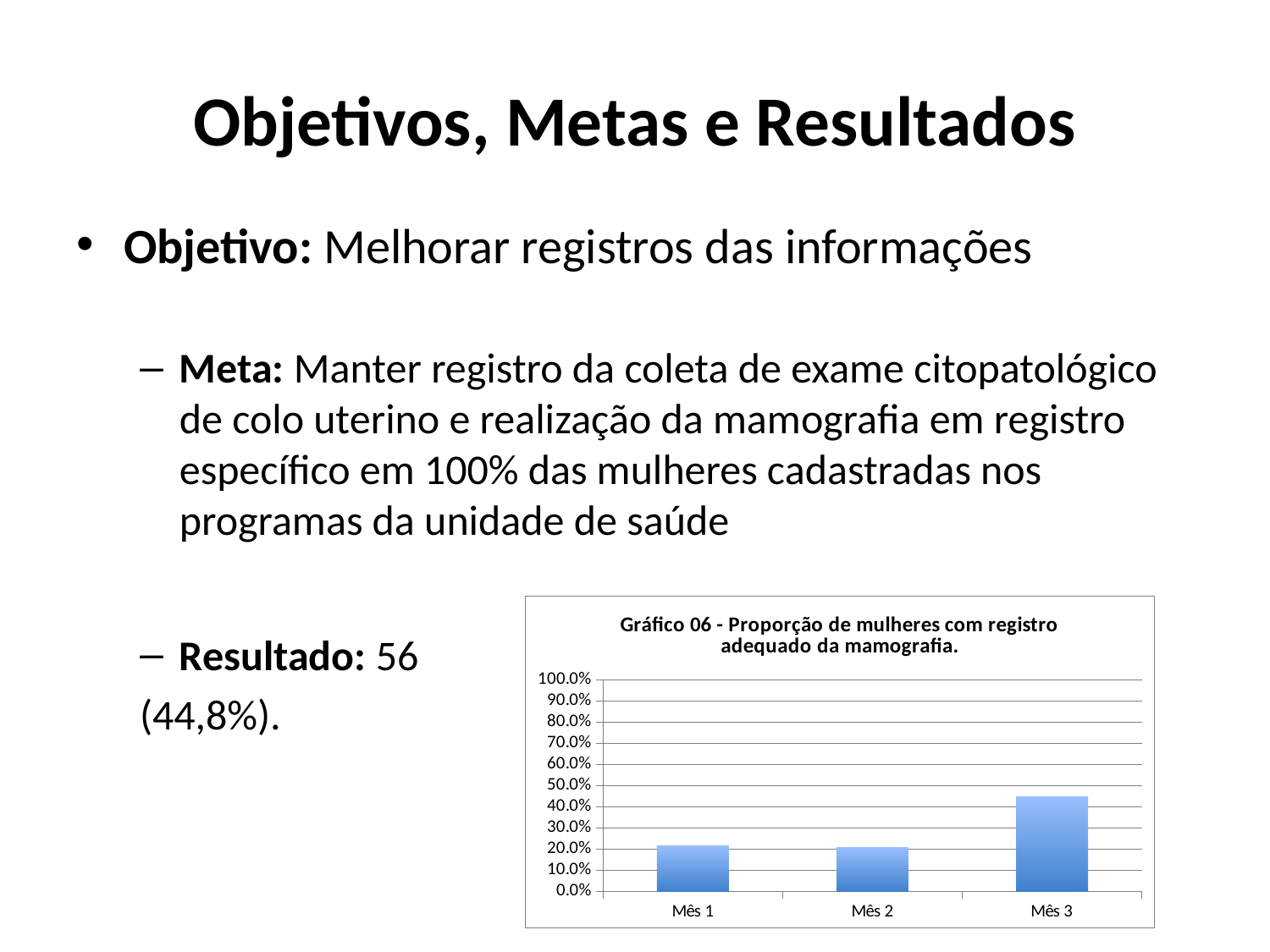
Is the value for Mês 2 greater or less than 30%? less Which is larger, the value for Mês 2 or the value for Mês 3? Mês 3 What kind of chart is shown on the slide? bar chart Is the value for Mês 3 greater or less than 50%? less Which month has the highest value in the chart? Mês 3 How many categories are plotted on the x axis of the chart? 3 What is the highest value shown on the chart's y axis? 100.0% Is the value for Mês 1 greater or less than 30%? less Which is larger, the value for Mês 1 or the value for Mês 3? Mês 3 What is the label of the last category on the x axis? Mês 3 What is the title of the chart? Gráfico 06 - Proporção de mulheres com registro adequado da mamografia.